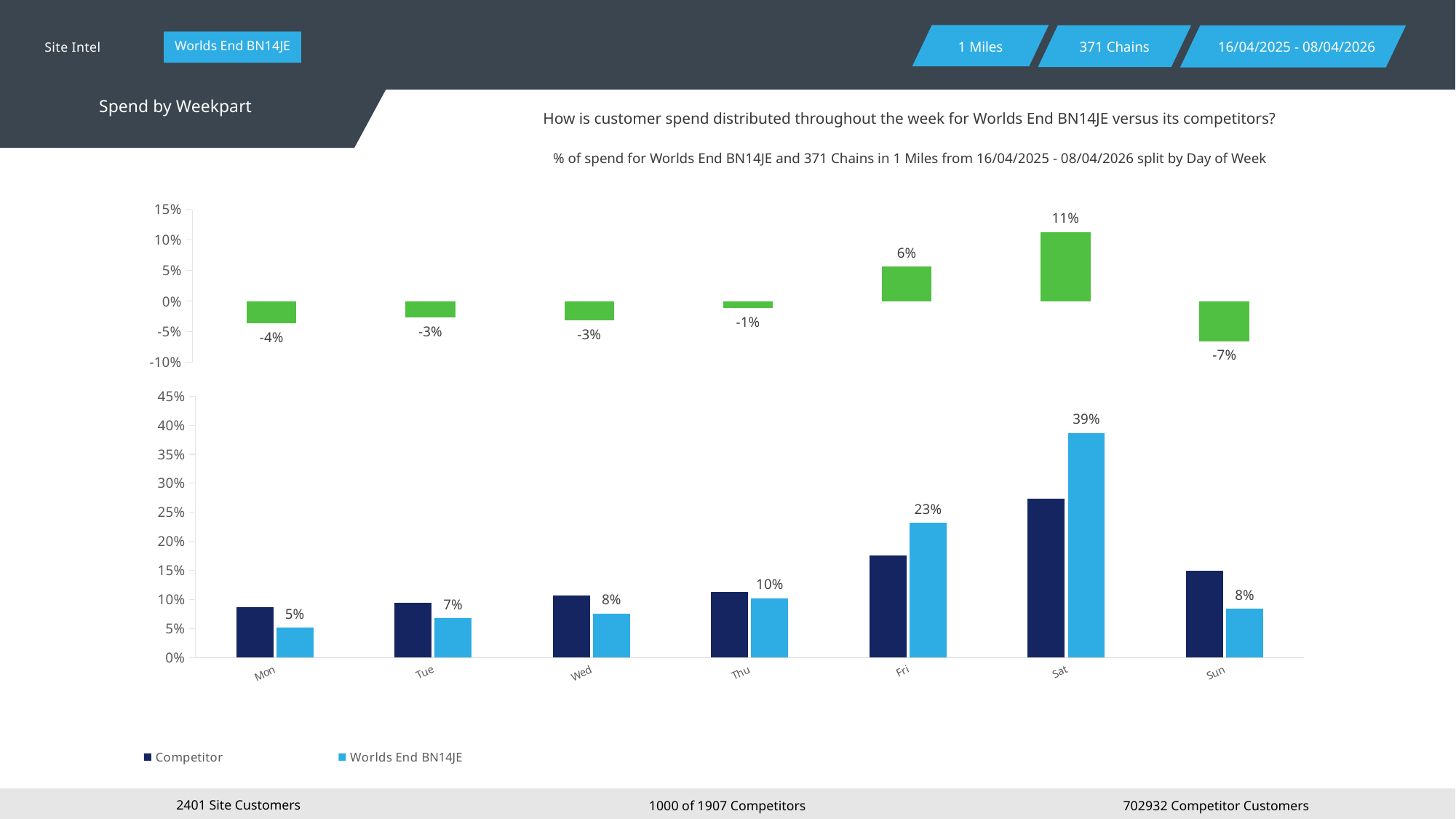
In the bottom chart, which day has the lowest value for Worlds End BN14JE? Mon How many days of the week are shown on the x axis of the bottom chart? 7 In the bottom chart, on Sun, which series has the larger value: Competitor or Worlds End BN14JE? Competitor In the bottom chart, what is the value for Worlds End BN14JE on Sat? 39% In the top chart, which day has the highest value? Sat In the top chart, what is the value shown for Sun? -7% In the top chart, which day has the lowest value? Sun In the bottom chart, is the Competitor value for Mon greater or less than 10%? less In the bottom chart, what is the value for Worlds End BN14JE on Fri? 23% How many series does the legend of the bottom chart list? 2 In the bottom chart, what is the difference between the Worlds End BN14JE values for Sat and Fri? 16% In the bottom chart, is the Competitor value for Sat greater or less than 25%? greater